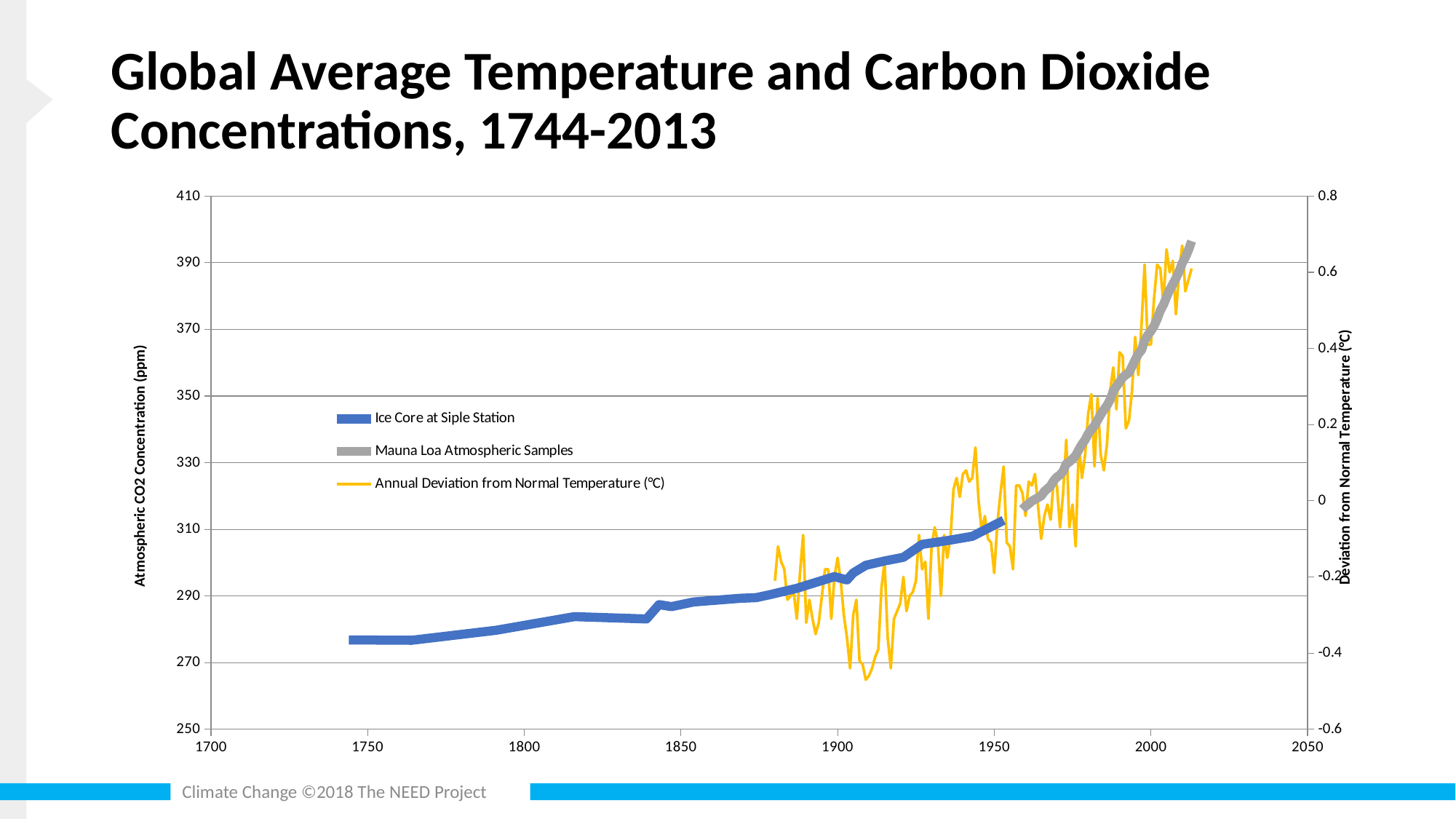
Does the Ice Core at Siple Station series rise or fall from 1744 to the 1950s? rise Is the Mauna Loa Atmospheric Samples value around 1980 greater or less than 330 ppm? greater Does the Mauna Loa Atmospheric Samples series rise or fall from 1960 to 2013? rise What is the title of the chart on the slide? Global Average Temperature and Carbon Dioxide Concentrations, 1744-2013 What is the label of the left vertical axis? Atmospheric CO2 Concentration (ppm) Is the Annual Deviation from Normal Temperature around 2010 greater or less than 0.4 °C? greater Is the Annual Deviation from Normal Temperature around 1910 greater or less than -0.2 °C? less How many series does the legend list? 3 What kind of chart is shown on the slide? line chart